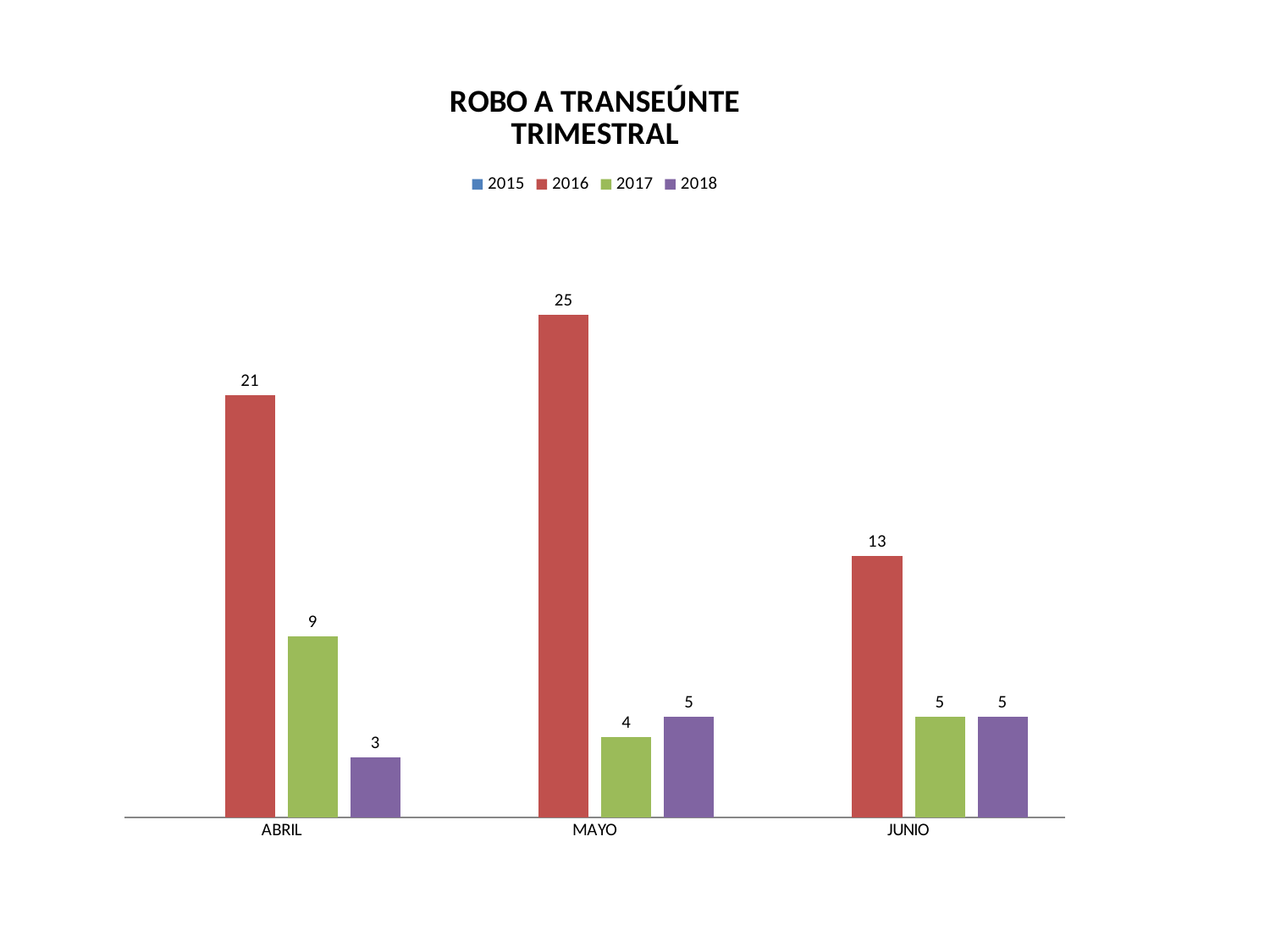
Does the 2016 value rise or fall from MAYO to JUNIO? Fall How many series does the legend list? 4 What is the value for 2016 in MAYO? 25 What kind of chart is this? Bar chart What is the value for 2017 in ABRIL? 9 How many months are shown on the x axis? 3 Which is larger, the 2017 value in ABRIL or the 2017 value in MAYO? ABRIL What is the difference between the 2016 values for MAYO and JUNIO? 12 What is the title of the chart? ROBO A TRANSEÚNTE TRIMESTRAL What is the value for 2018 in JUNIO? 5 In which month is the 2016 value highest? MAYO In which month is the 2018 value lowest? ABRIL